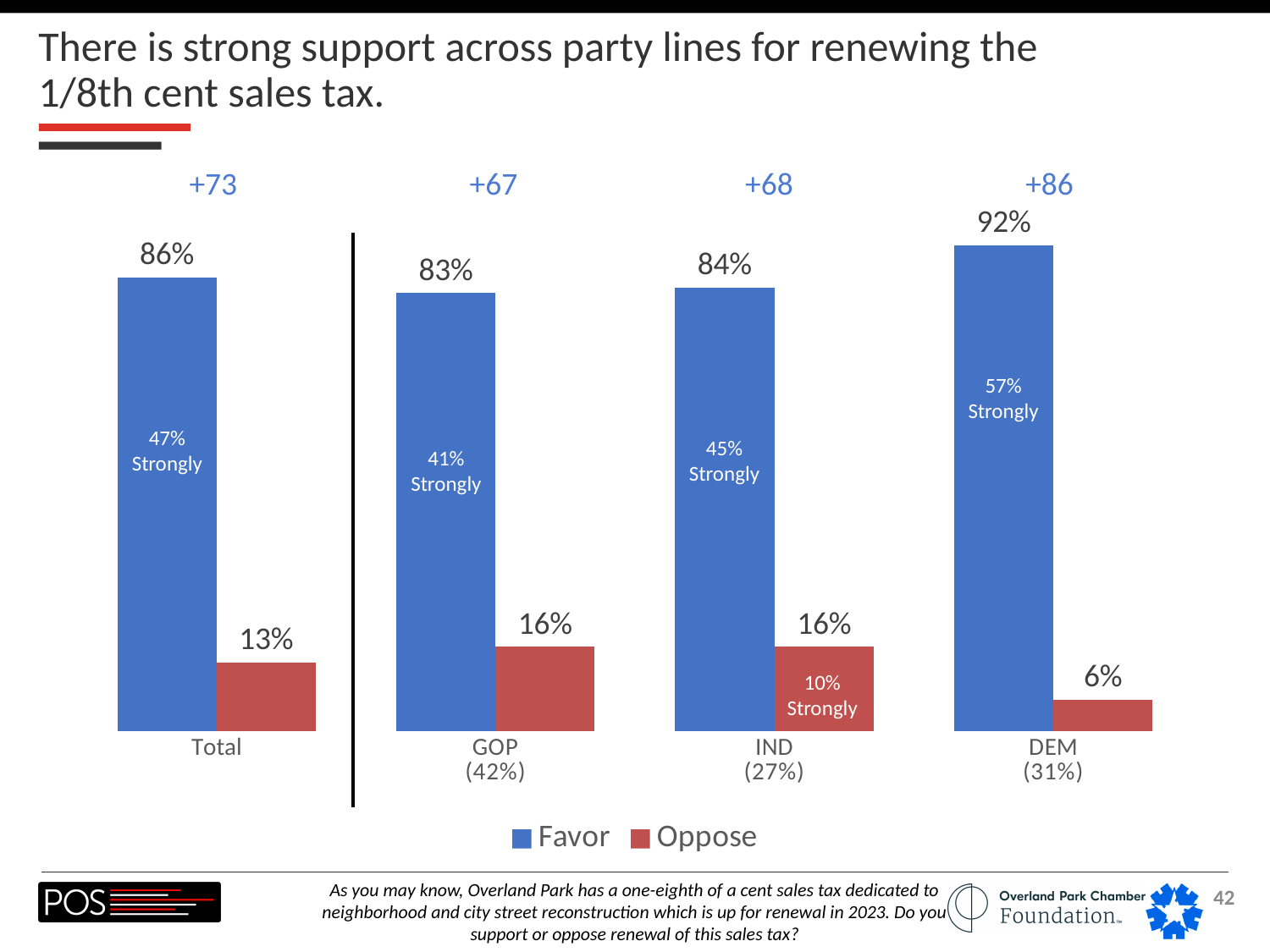
What percentage of DEM respondents favor renewing the sales tax? 92% What percentage of the Total group favors renewing the sales tax? 86% What share of IND respondents strongly favor renewing the sales tax? 45% How many series does the legend list? 2 What net margin is shown above the DEM group? +86 Which is larger, the Favor value for GOP or the Favor value for IND? IND Which group has the highest Favor value? DEM Which group has the lowest Oppose value? DEM How many groups are shown on the x axis? 4 What kind of chart is shown on the slide? Bar chart What percentage of GOP respondents oppose renewing the sales tax? 16% What is the difference between the Favor and Oppose values for the Total group? 73